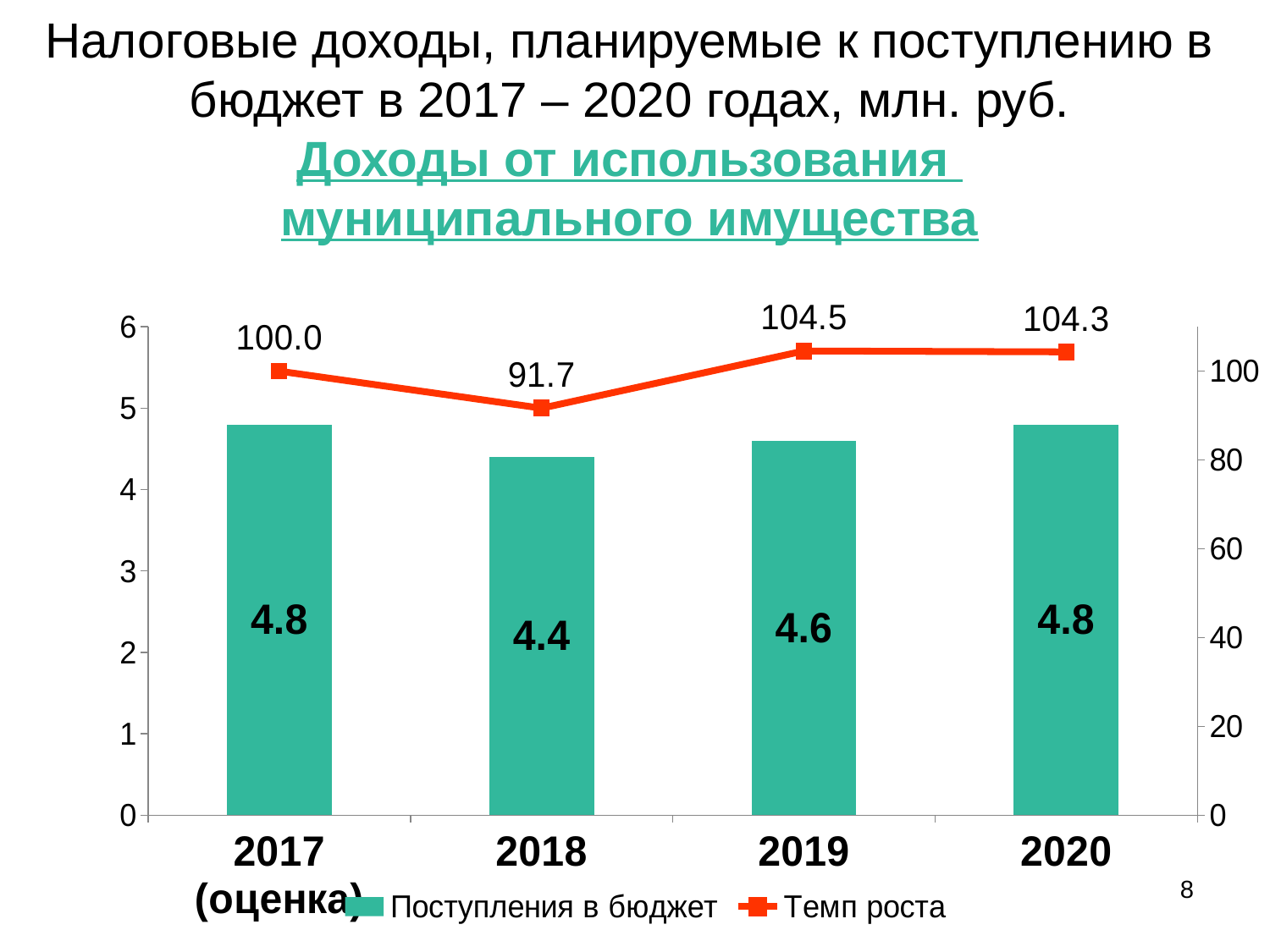
What is the difference between Поступления в бюджет in 2020 and in 2018? 0.4 What is the value of Темп роста for 2017 (оценка)? 100.0 What is the value of Темп роста for 2019? 104.5 How many series does the legend list? 2 Which year has the lowest value of Темп роста? 2018 What kind of chart is used for the Поступления в бюджет series? bar chart How many years are shown on the x axis? 4 What is the value of Поступления в бюджет for 2018? 4.4 Which is larger: Темп роста in 2018 or in 2019? 2019 Does Поступления в бюджет rise or fall from 2018 to 2020? rise What colour is the Темп роста line? red Which year has the lowest value of Поступления в бюджет? 2018